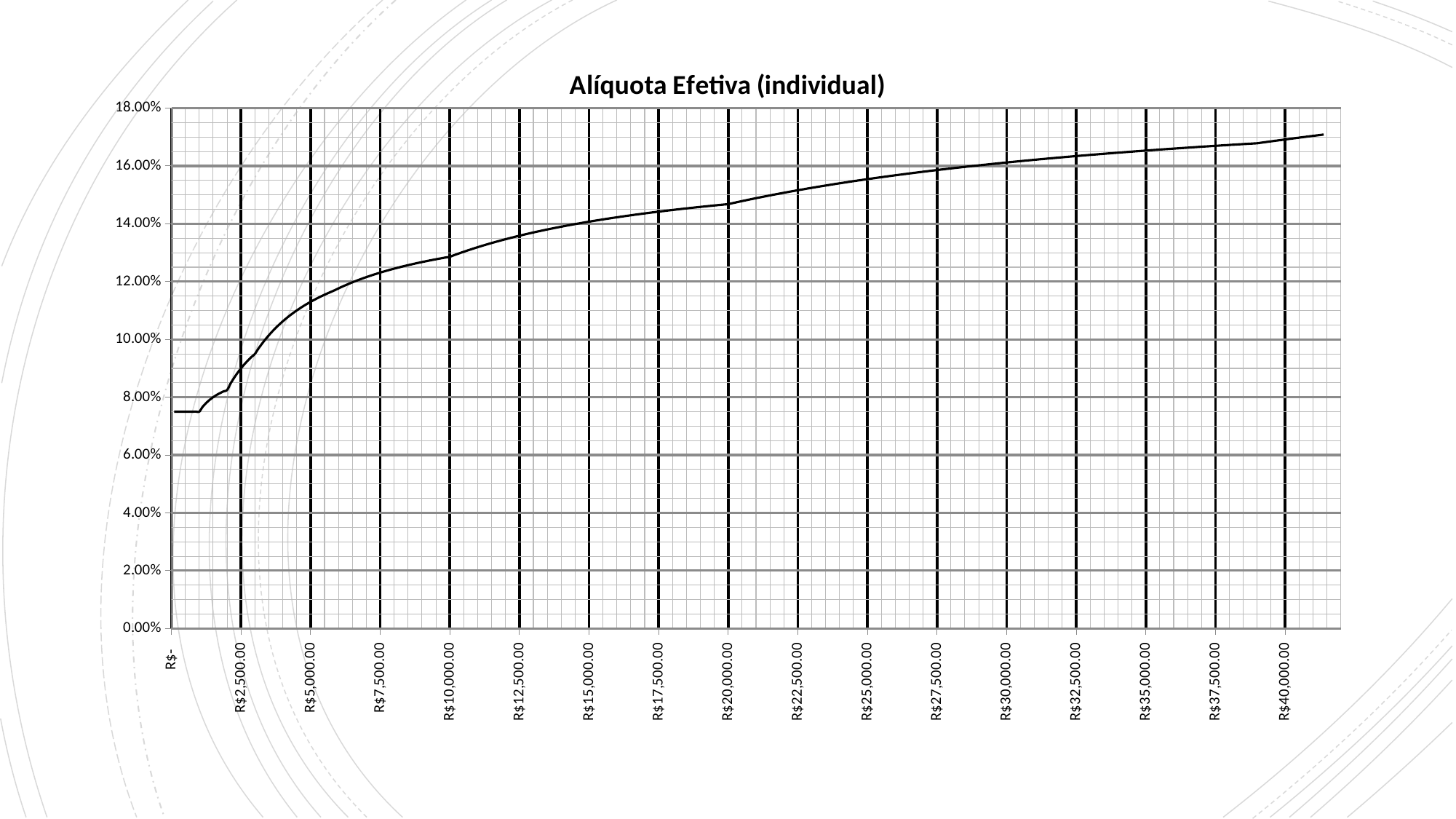
What is the title of the chart? Alíquota Efetiva (individual) Do the values rise or fall as the x axis moves from R$- to R$40,000.00? rise Is the value at R$20,000.00 greater or less than 14.00%? greater What kind of chart is shown on the slide? line chart Is the value at R$- greater or less than 8.00%? less Is the value at R$10,000.00 greater or less than 14.00%? less What is the highest value shown on the y axis? 18.00% Which is larger, the value at R$2,500.00 or the value at R$40,000.00? R$40,000.00